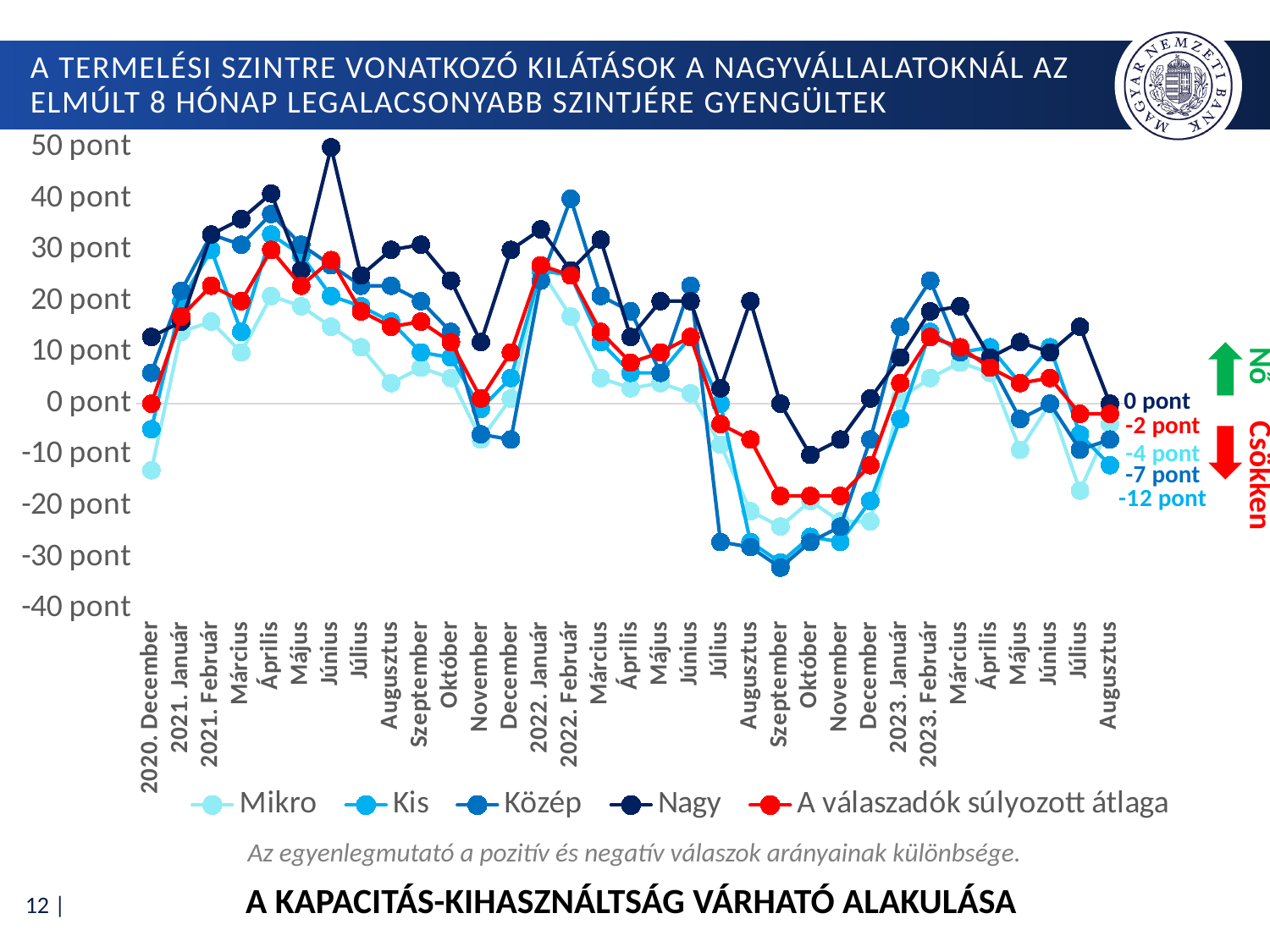
What is the value labelled for 'A válaszadók súlyozott átlaga' at the end of the chart (2023. Augusztus)? -2 pont Is the value for Nagy in 2021. Június greater or less than 40 pont? greater Is the value for Nagy in 2022. Augusztus greater or less than 10 pont? greater What is the lowest of the end-point values labelled at the right of the chart? -12 pont How many months are shown along the x axis? 33 How many series does the legend list? 5 Which series is drawn in red? A válaszadók súlyozott átlaga In 2021. Április, which series has the higher value: Nagy or Mikro? Nagy What kind of chart is shown on the slide? line chart Does the Nagy series rise or fall between 2023. Február and 2023. Augusztus? fall Is the value for 'A válaszadók súlyozott átlaga' in 2022. Szeptember greater or less than -10 pont? less What is the value labelled for the Nagy series at the end of the chart (2023. Augusztus)? 0 pont